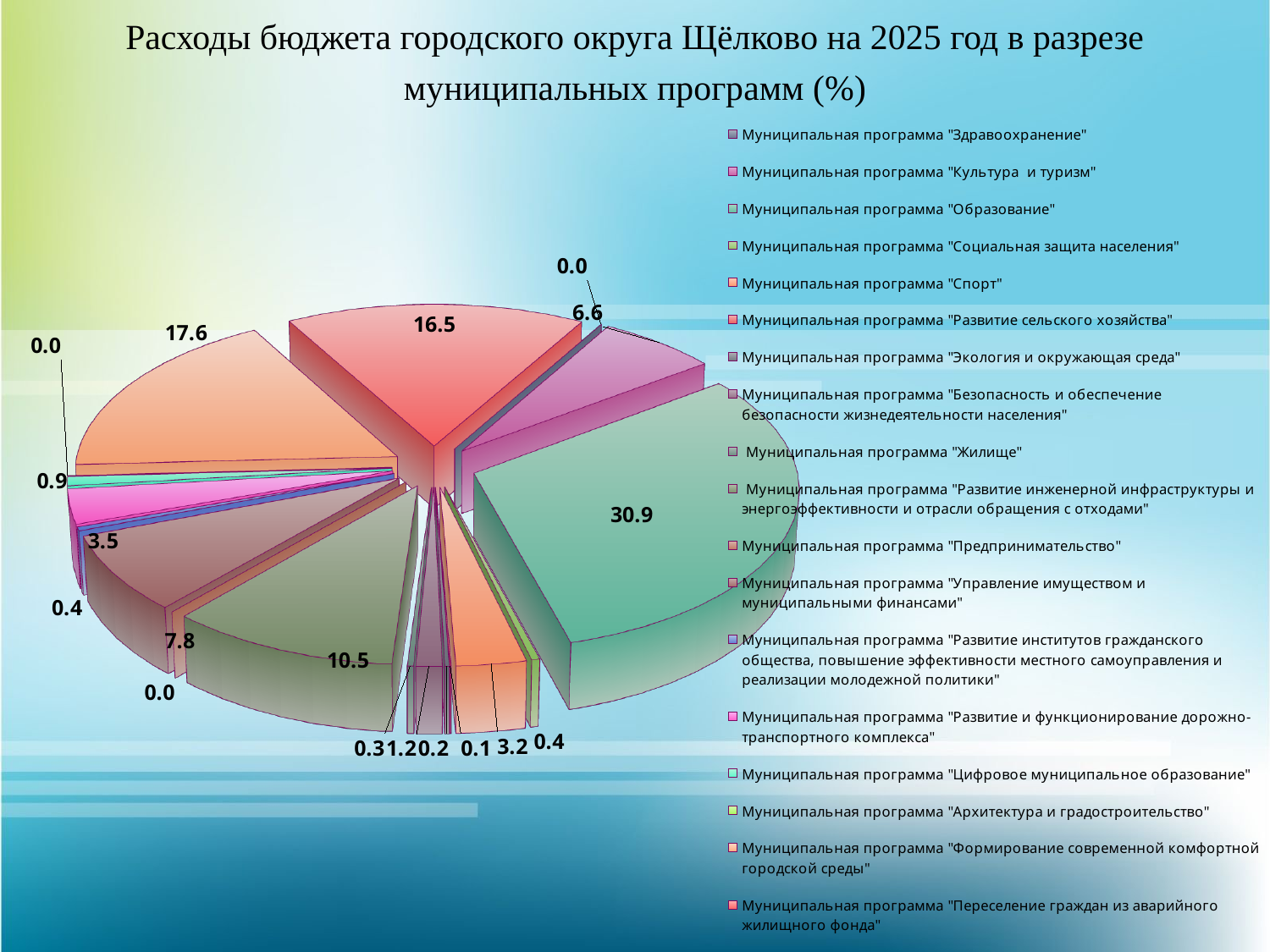
What is the second-largest value labelled on the pie chart? 17.6 What is the title of the chart on the slide? Расходы бюджета городского округа Щёлково на 2025 год в разрезе муниципальных программ (%) How many entries does the legend of the pie chart list? 18 What is the difference between the slices labelled 10.5 and 7.8? 2.7 What kind of chart is shown on the slide? pie chart How many slices of the pie chart are labelled 0.0? 3 What is the difference between the largest labelled slice (30.9) and the slice labelled 17.6? 13.3 Where is the legend placed relative to the pie chart? to the right What is the difference between the slices labelled 17.6 and 16.5? 1.1 Which is larger, the slice labelled 10.5 or the slice labelled 7.8? 10.5 What is the largest value labelled on the pie chart? 30.9 How many data labels are printed around the pie chart? 18